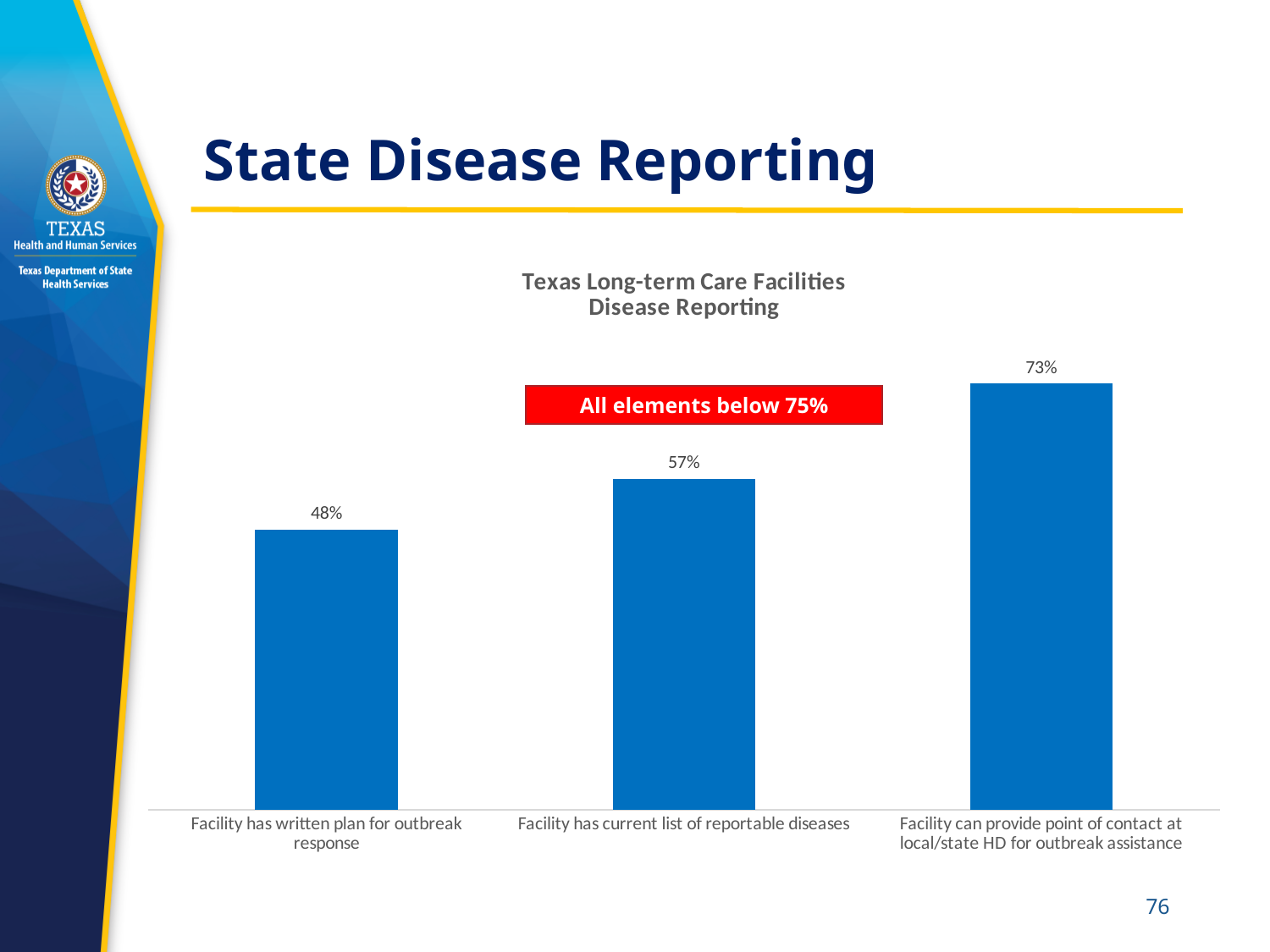
Do the values rise or fall from left to right across the categories? Rise Which is larger: the value for 'Facility has current list of reportable diseases' or 'Facility has written plan for outbreak response'? Facility has current list of reportable diseases How many categories are shown in the chart? 3 Which category has the lowest value? Facility has written plan for outbreak response What is the difference between the values for 'Facility has current list of reportable diseases' and 'Facility has written plan for outbreak response'? 9% What is the title of the chart? Texas Long-term Care Facilities Disease Reporting What is the value for 'Facility has written plan for outbreak response'? 48% What is the difference between the values for 'Facility can provide point of contact at local/state HD for outbreak assistance' and 'Facility has written plan for outbreak response'? 25% What is the value for 'Facility has current list of reportable diseases'? 57% What is the value for 'Facility can provide point of contact at local/state HD for outbreak assistance'? 73% Which category has the highest value? Facility can provide point of contact at local/state HD for outbreak assistance What kind of chart is shown on the slide? Bar chart